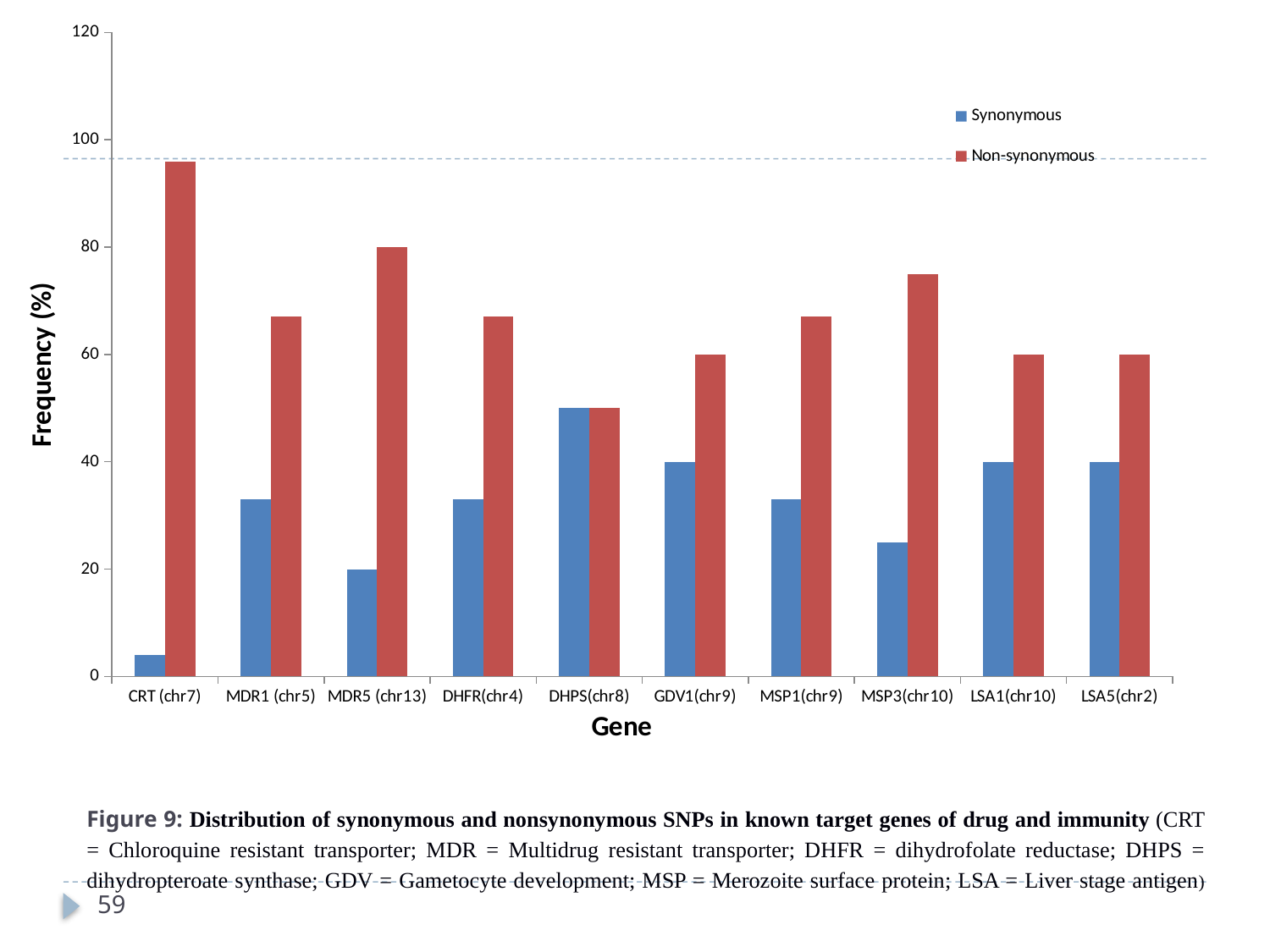
Which is larger: the Non-synonymous value for MDR5 (chr13) or for DHFR(chr4)? MDR5 (chr13) What is the Synonymous frequency for MDR5 (chr13)? 20 What kind of chart is shown on the slide? bar chart What is the Non-synonymous frequency for GDV1(chr9)? 60 Is the Synonymous value for MSP3(chr10) greater or less than 40? less Which gene has the highest Synonymous frequency? DHPS(chr8) Is the Non-synonymous value for CRT (chr7) greater or less than 80? greater Which gene has the highest Non-synonymous frequency? CRT (chr7) How many series does the legend list? 2 What is the title of the y axis? Frequency (%) How many genes are shown on the x axis? 10 Which gene has the lowest Synonymous frequency? CRT (chr7)